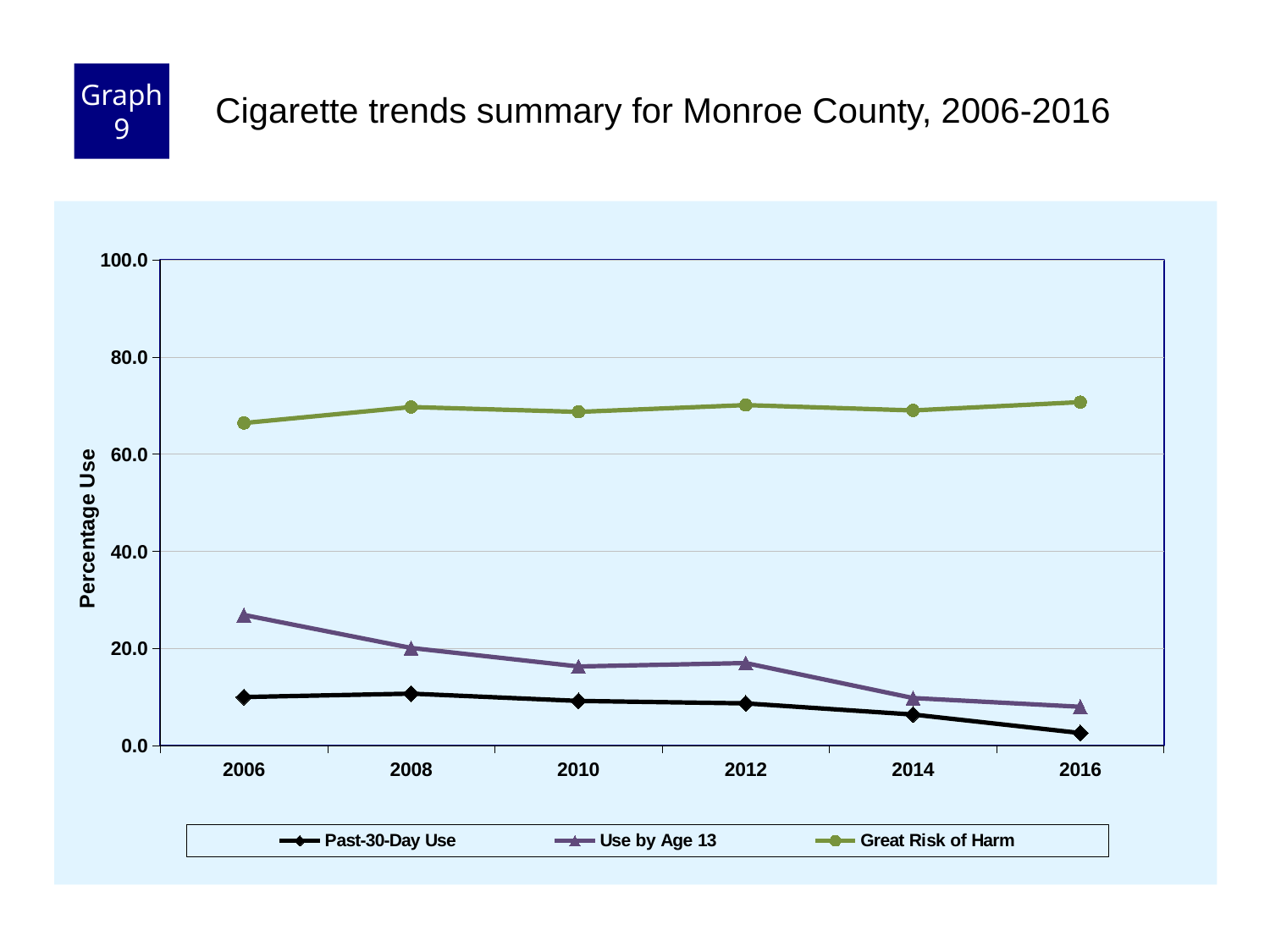
Is the value for Use by Age 13 in 2016 greater or less than 20? less How many years are plotted along the x axis? 6 Is the value for Past-30-Day Use in 2016 greater or less than 20? less Is the value for Use by Age 13 in 2006 greater or less than 20? greater Does Use by Age 13 rise or fall from 2006 to 2016? fall How many series does the legend list? 3 In which year is Past-30-Day Use lowest? 2016 In which year is Use by Age 13 highest? 2006 What is the title of the chart? Cigarette trends summary for Monroe County, 2006-2016 What kind of chart is shown on the slide? line chart What is the label on the vertical axis? Percentage Use